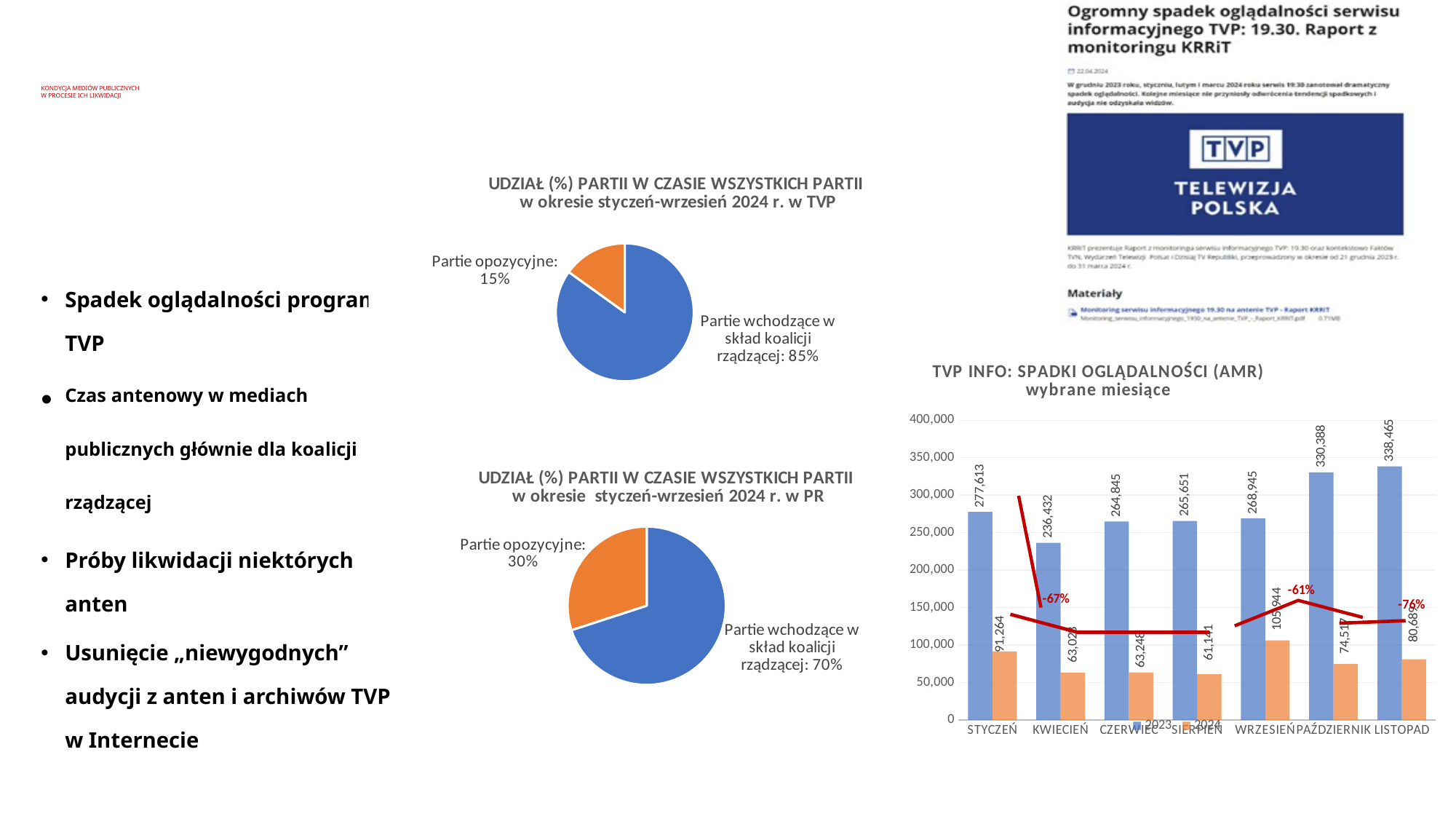
In the chart 'TVP INFO: SPADKI OGLĄDALNOŚCI (AMR) wybrane miesiące', what is the 2024 value for STYCZEŃ? 91,264 In the chart 'TVP INFO: SPADKI OGLĄDALNOŚCI (AMR) wybrane miesiące', what is the 2023 value for LISTOPAD? 338,465 In the pie chart for PR (bottom middle), how many slices does the pie have? 2 What kind of chart is the chart titled 'TVP INFO: SPADKI OGLĄDALNOŚCI (AMR) wybrane miesiące'? bar chart In the chart 'TVP INFO: SPADKI OGLĄDALNOŚCI (AMR) wybrane miesiące', what is the difference between the 2023 values for LISTOPAD and PAŹDZIERNIK? 8,077 In the pie chart titled 'UDZIAŁ (%) PARTII W CZASIE WSZYSTKICH PARTII w okresie styczeń-wrzesień 2024 r. w PR', what share do 'Partie opozycyjne' have? 30% In the chart 'TVP INFO: SPADKI OGLĄDALNOŚCI (AMR) wybrane miesiące', what is the 2023 value for STYCZEŃ? 277,613 In the pie chart for TVP (top middle), what share do 'Partie wchodzące w skład koalicji rządzącej' have? 85% In the pie chart for PR (bottom middle), what share do 'Partie wchodzące w skład koalicji rządzącej' have? 70% In the chart 'TVP INFO: SPADKI OGLĄDALNOŚCI (AMR) wybrane miesiące', which month has the highest 2023 value? LISTOPAD In the chart 'TVP INFO: SPADKI OGLĄDALNOŚCI (AMR) wybrane miesiące', how many months are shown on the x axis? 7